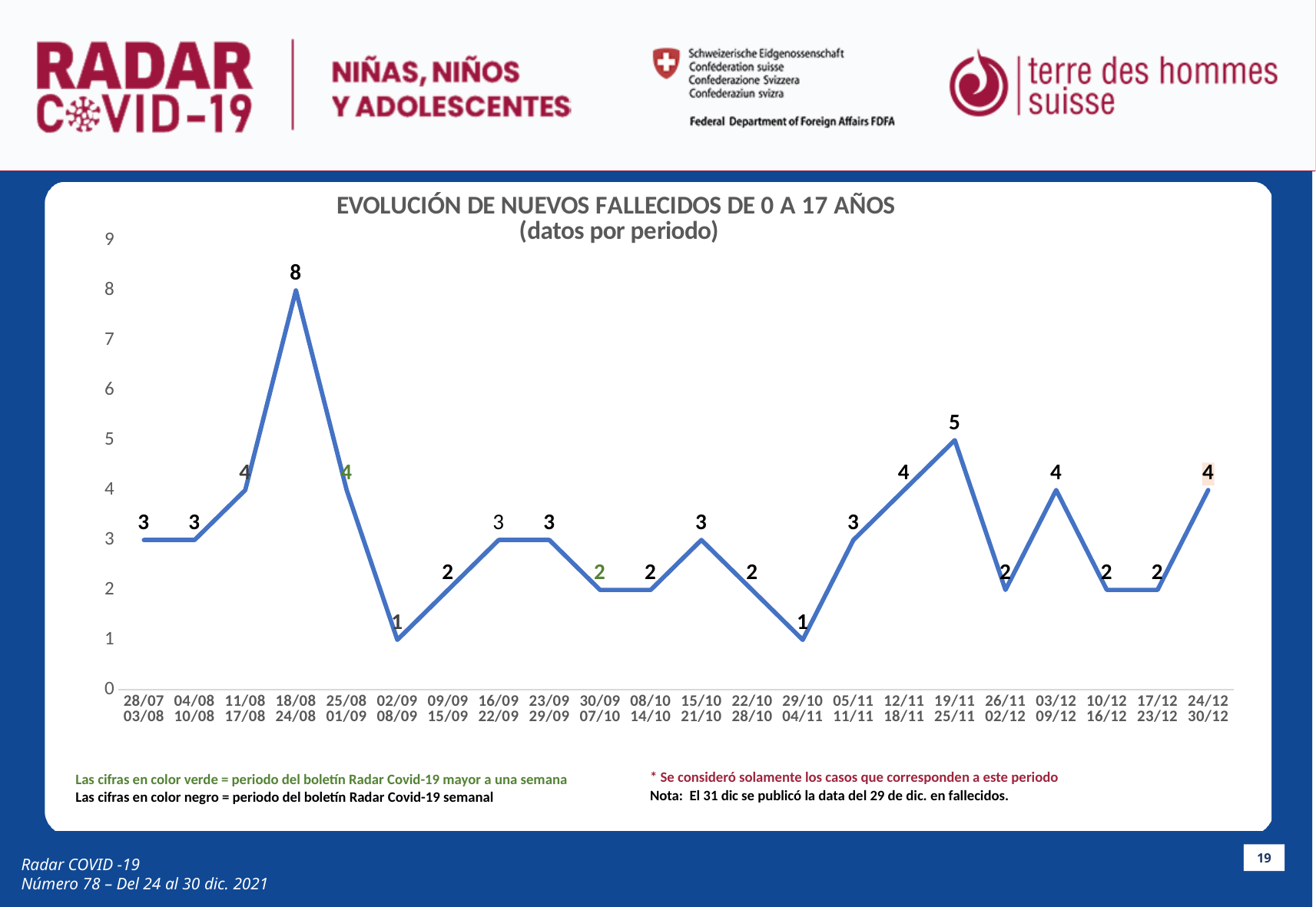
How many periods are plotted on the x axis? 22 What is the value for the period 18/08-24/08? 8 What kind of chart is shown on the slide? line chart Do the values rise or fall from 29/10-04/11 to 19/11-25/11? rise What is the value for the period 19/11-25/11? 5 Which is larger, the value for 12/11-18/11 or the value for 10/12-16/12? 12/11-18/11 What is the value for the period 02/09-08/09? 1 What is the difference between the values for 18/08-24/08 and 25/08-01/09? 4 What is the title of the chart? EVOLUCIÓN DE NUEVOS FALLECIDOS DE 0 A 17 AÑOS (datos por periodo) What is the difference between the values for 19/11-25/11 and 26/11-02/12? 3 What is the value for the period 24/12-30/12? 4 Which period has the highest value? 18/08-24/08